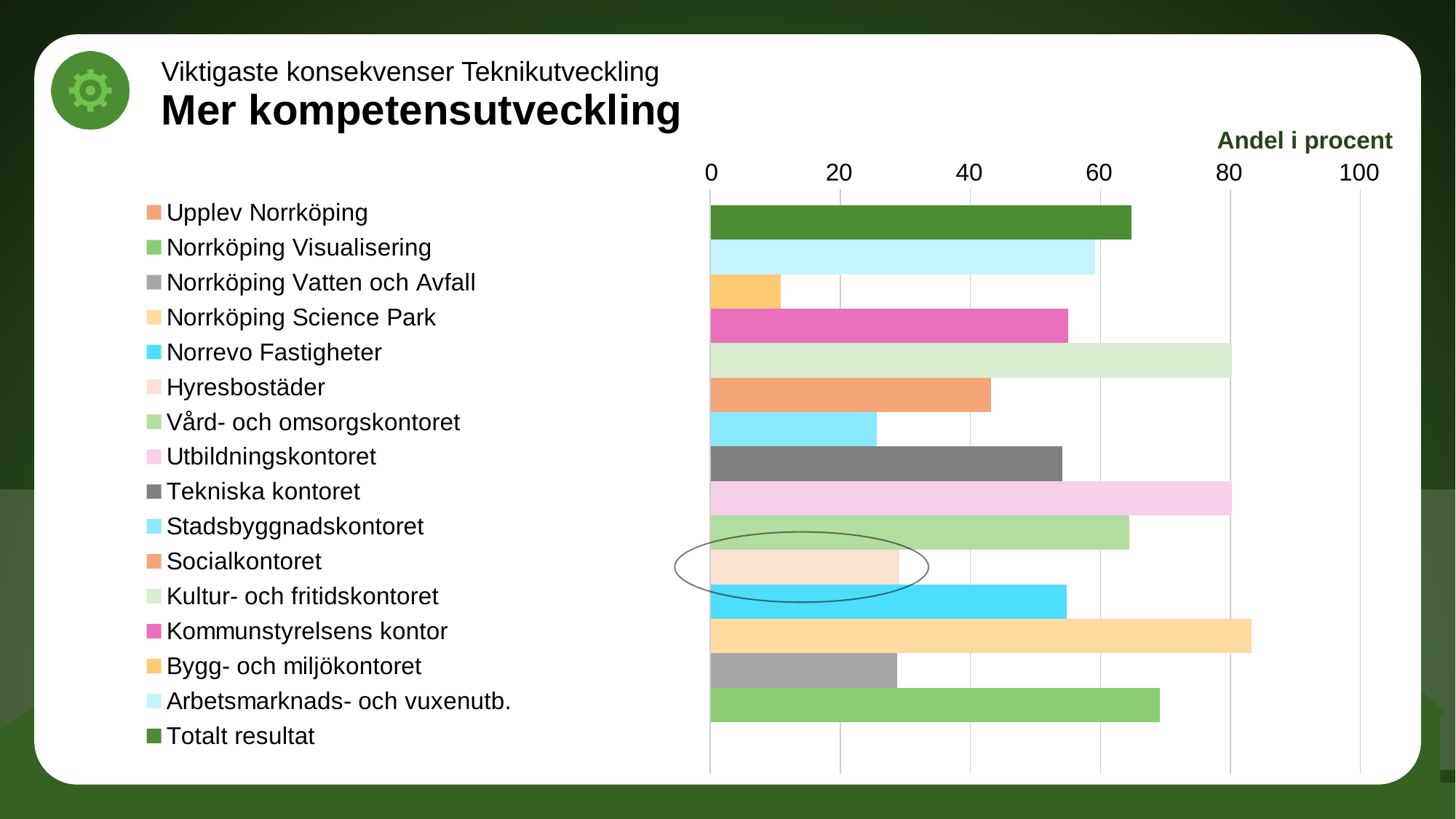
Which has the larger value, Kultur- och fritidskontoret or Stadsbyggnadskontoret? Kultur- och fritidskontoret What kind of chart is shown on the slide? bar chart Is the value for Hyresbostäder greater or less than 40? less Which has the larger value, Totalt resultat or Socialkontoret? Totalt resultat Is the value for Totalt resultat greater or less than 60? greater Among the bars drawn in the chart, which legend entry has the shortest bar? Bygg- och miljökontoret What is the title shown above the horizontal axis of the chart? Andel i procent How many entries does the chart's legend list? 16 Is the value for Norrköping Visualisering greater or less than 60? greater Which legend entry has the longest bar in the chart? Norrköping Science Park